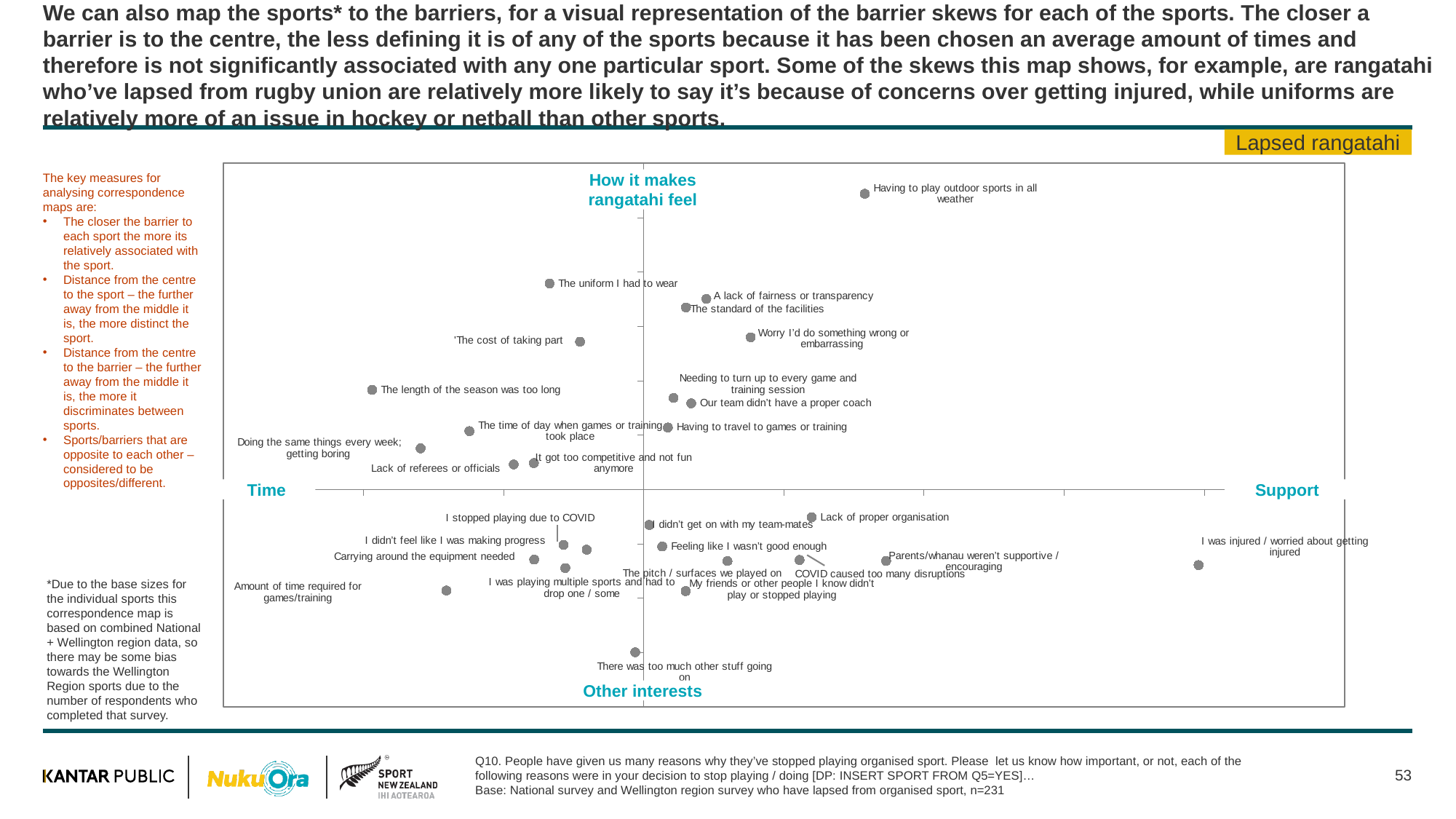
Which is plotted further to the left: 'Amount of time required for games/training' or 'Carrying around the equipment needed'? Amount of time required for games/training Which barrier is plotted highest on the chart, closest to the 'How it makes rangatahi feel' label? Having to play outdoor sports in all weather What are the labels at the left and right ends of the horizontal axis? Time and Support What group does the yellow label above the chart say the map is for? Lapsed rangatahi Which is plotted further to the right: 'Lack of proper organisation' or 'I didn't get on with my team-mates'? Lack of proper organisation Is 'Worry I'd do something wrong or embarrassing' plotted to the left or right of the vertical axis? right Which barrier is plotted furthest to the right, closest to the 'Support' label? I was injured / worried about getting injured Which barrier is plotted lowest on the chart, closest to the 'Other interests' label? There was too much other stuff going on Which barrier is plotted furthest to the left, closest to the 'Time' label? The length of the season was too long What kind of chart is shown on the slide? scatter plot